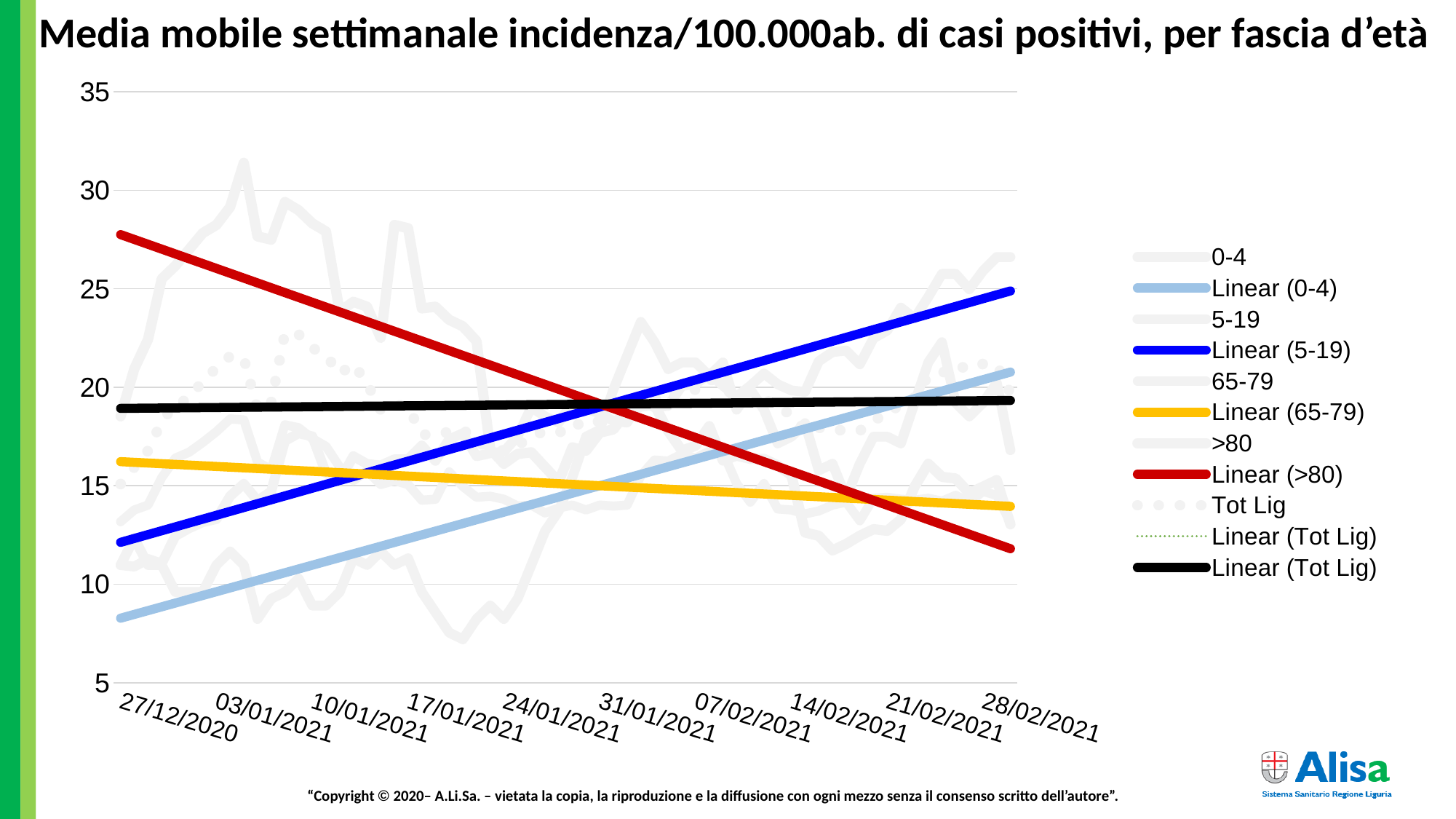
What colour is the Linear (>80) line in the legend? red What kind of chart is shown on the slide? line chart Is the value of the Linear (5-19) line at 28/02/2021 greater or less than 20? greater Is the value of the Linear (>80) line at 27/12/2020 greater or less than 25? greater Does the Linear (>80) trend line rise or fall from 27/12/2020 to 28/02/2021? fall At 27/12/2020, which is larger: the Linear (>80) line or the Linear (0-4) line? Linear (>80) Does the Linear (0-4) trend line rise or fall across the x axis? rise At 28/02/2021, which is larger: the Linear (5-19) line or the Linear (>80) line? Linear (5-19) How many date labels are shown on the x axis? 10 Is the value of the Linear (0-4) line at 27/12/2020 greater or less than 10? less Does the Linear (5-19) trend line rise or fall across the x axis? rise How many entries does the legend list? 11